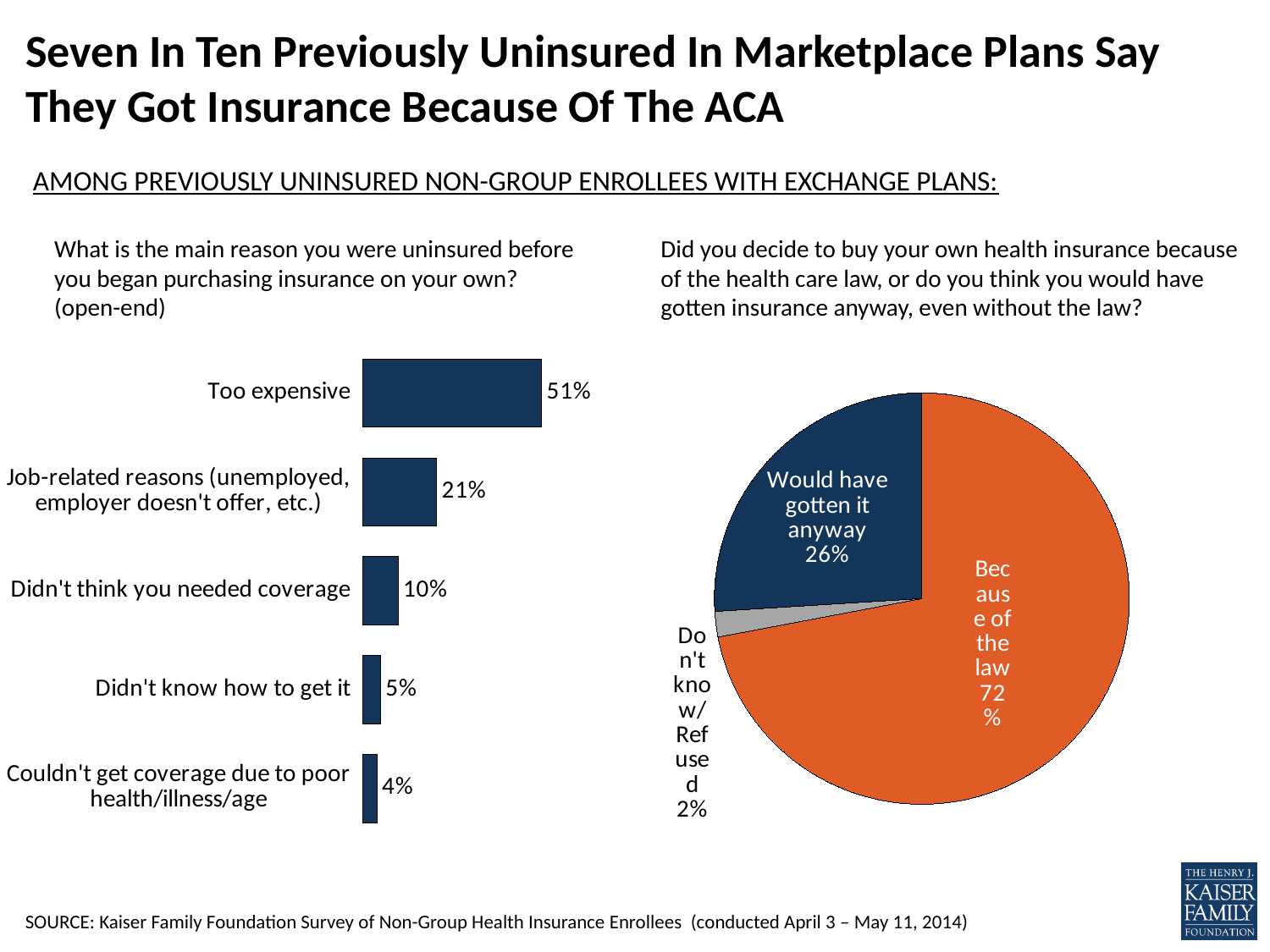
In the bar chart on the left, how many reasons are listed? 5 What type of chart is on the right side of the slide? Pie chart In the bar chart on the left, which reason has the highest percentage? Too expensive In the bar chart on the left, which is larger: 'Didn't think you needed coverage' or 'Didn't know how to get it'? Didn't think you needed coverage In the bar chart on the left, what percentage cited job-related reasons? 21% In the pie chart on the right, what share said they bought insurance because of the law? 72% In the bar chart on the left, what percentage said 'Too expensive' was the main reason they were uninsured? 51% In the bar chart on the left, which reason has the lowest percentage? Couldn't get coverage due to poor health/illness/age What type of chart is on the left side of the slide? Bar chart In the pie chart on the right, what share said they would have gotten insurance anyway? 26% In the bar chart on the left, what is the difference between 'Too expensive' and 'Job-related reasons'? 30 percentage points In the pie chart on the right, what share is 'Don't know/Refused'? 2%